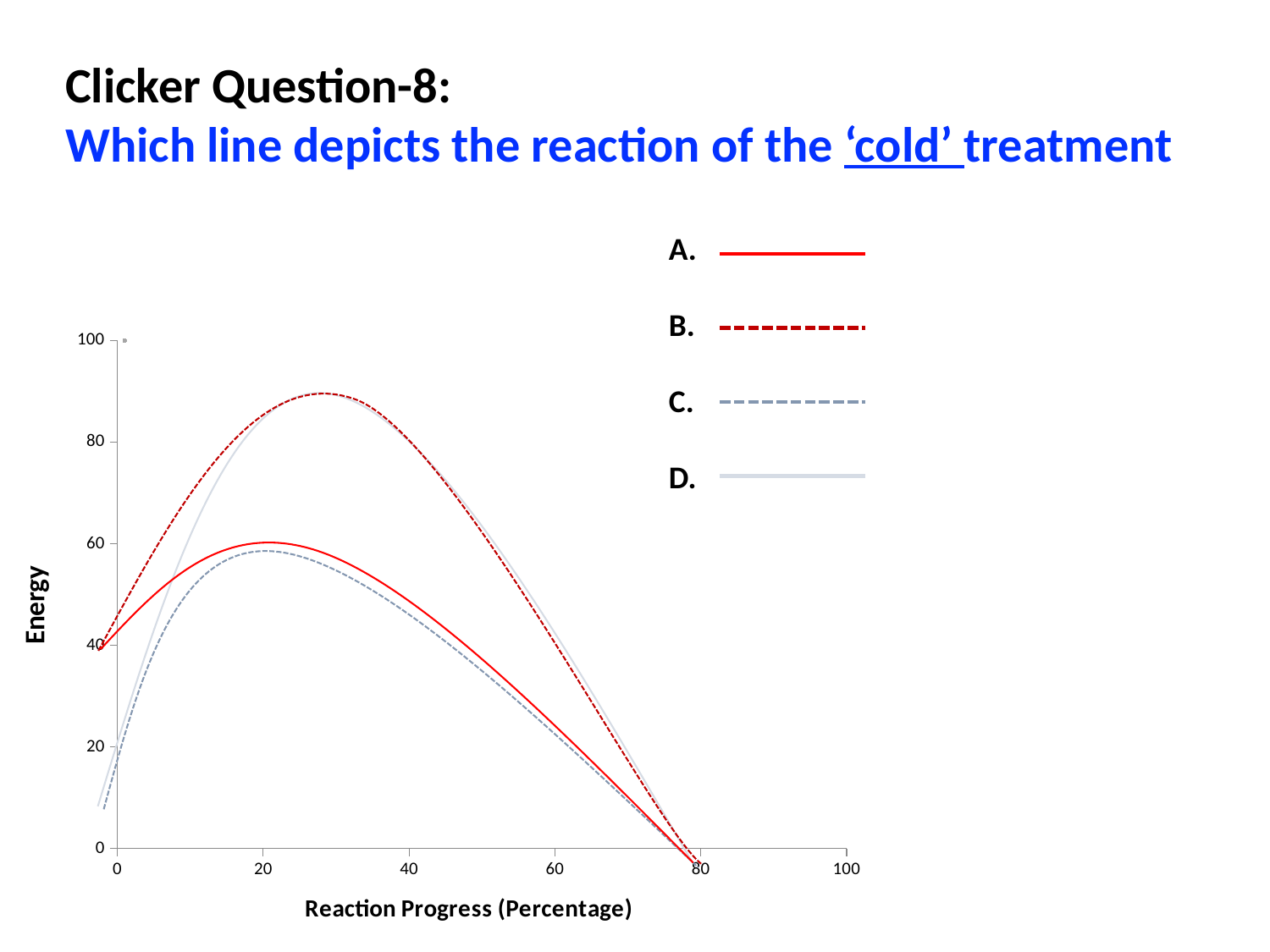
Is the peak value of line C greater or less than 80? less Is the value of line B at a reaction progress of 60 greater or less than 40? greater At what reaction progress value do all four lines reach an energy of 0? 80 Which line reaches a higher peak, line A or line B? line B What kind of chart is shown on the slide? line chart Is the peak value of line B greater or less than 80? greater How many lines (A through D) are listed in the key beside the chart? 4 What is the title of the horizontal axis? Reaction Progress (Percentage) After reaching their peaks, do the lines rise or fall as reaction progress increases? fall What is the title of the vertical axis? Energy